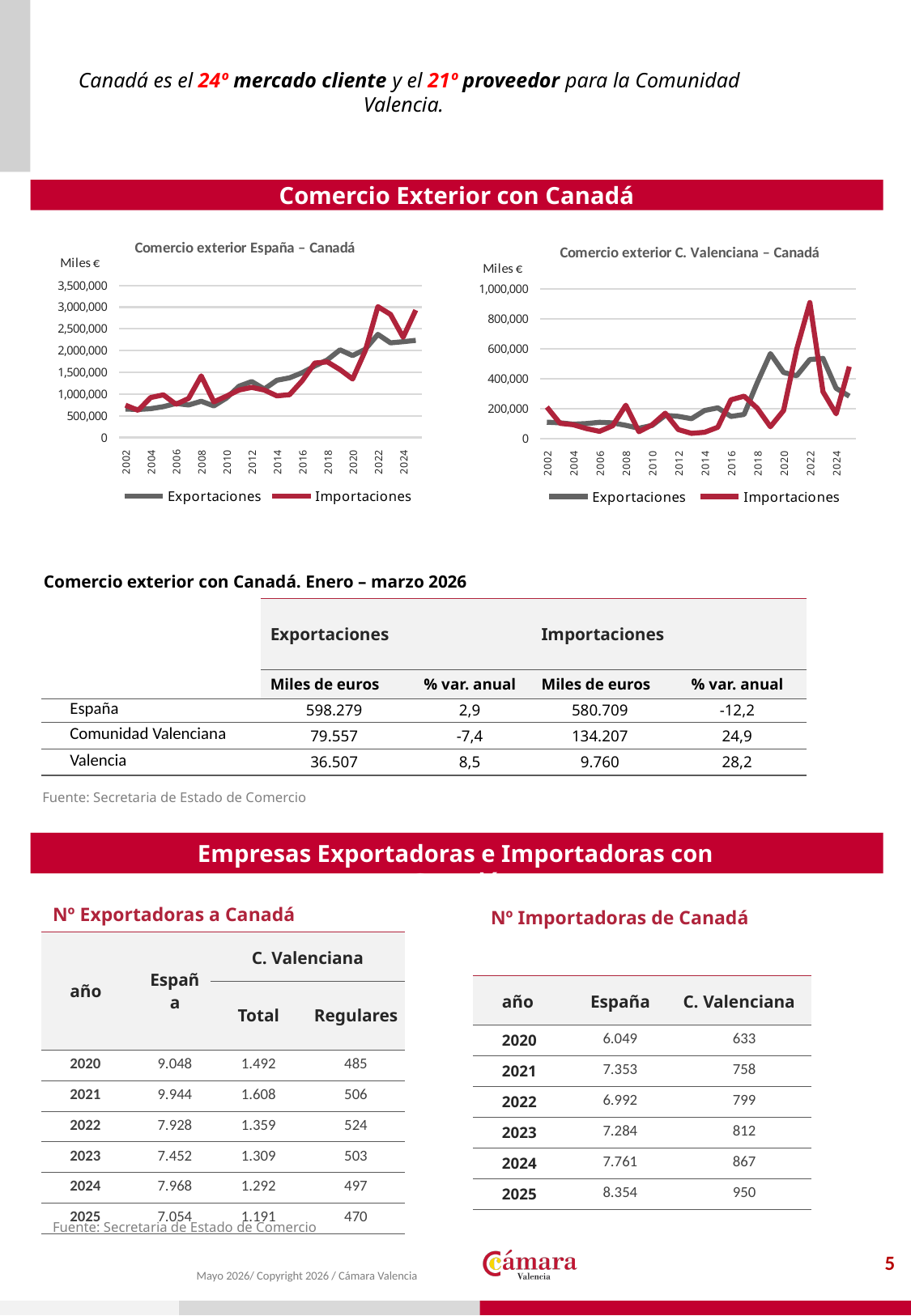
In the 'Comercio exterior C. Valenciana – Canadá' chart, which series reaches the highest value over the whole period? Importaciones In the 'Comercio exterior España – Canadá' chart, which series is larger in 2022, Exportaciones or Importaciones? Importaciones In the 'Comercio exterior C. Valenciana – Canadá' chart, which series is larger in 2022, Exportaciones or Importaciones? Importaciones In the 'Comercio exterior C. Valenciana – Canadá' chart, is the value of Exportaciones in 2002 greater or less than 200,000? less How many series does the legend of the 'Comercio exterior C. Valenciana – Canadá' chart list? 2 What type of chart is 'Comercio exterior España – Canadá'? Line chart In the 'Comercio exterior España – Canadá' chart, is the value of Exportaciones in 2002 greater or less than 1,000,000? less In the 'Comercio exterior C. Valenciana – Canadá' chart, is the peak value of Importaciones greater or less than 800,000? greater What unit is shown on the y axis of the 'Comercio exterior C. Valenciana – Canadá' chart? Miles € In the 'Comercio exterior España – Canadá' chart, do Exportaciones overall rise or fall from 2002 to 2024? Rise In the 'Comercio exterior España – Canadá' chart, which series is drawn in red? Importaciones